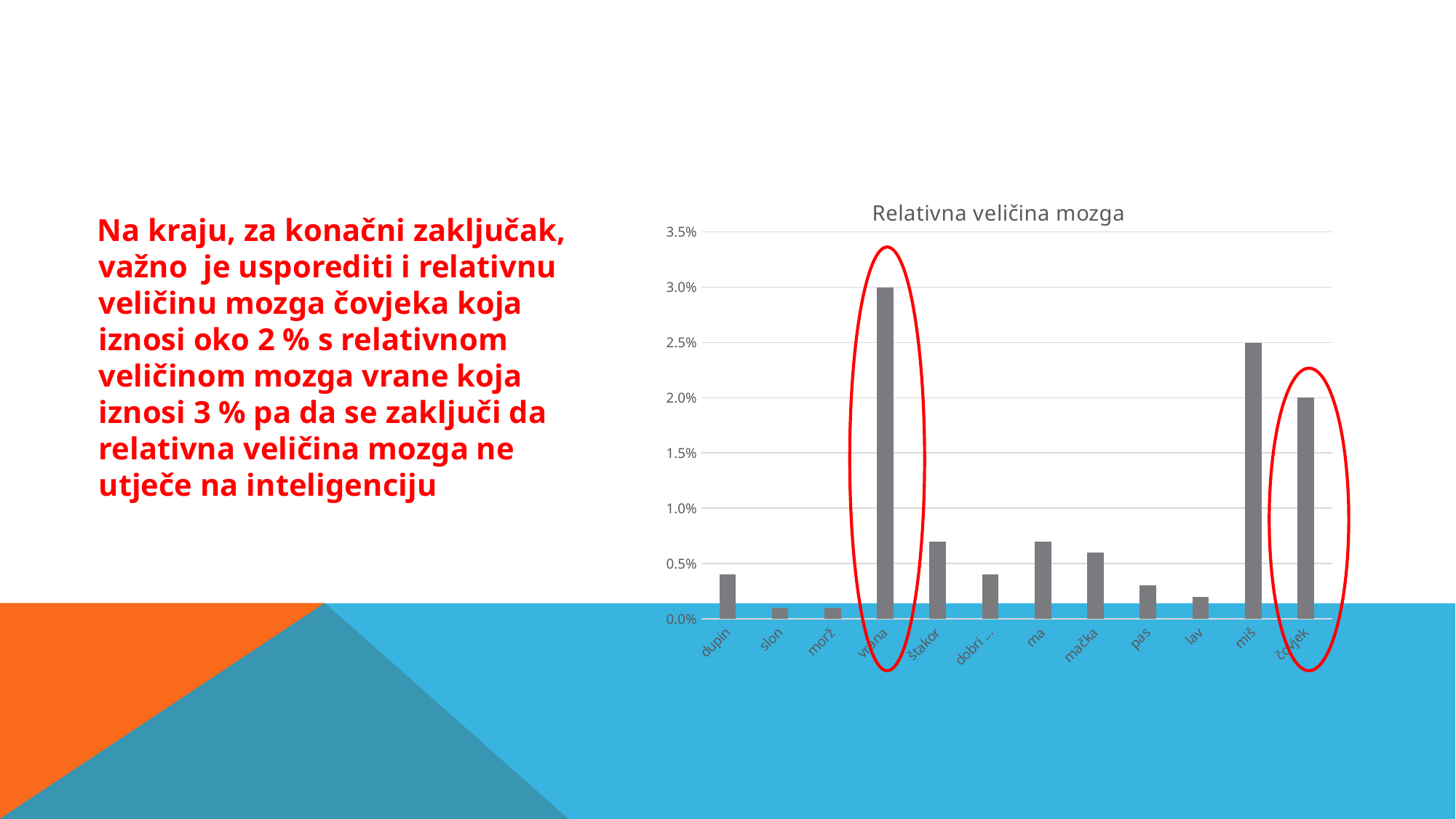
Is the value for mačka greater or less than 0.5%? greater What kind of chart is shown on the slide? bar chart What is the value for vrana in the chart? 3.0% What is the title of the chart? Relativna veličina mozga What is the value for čovjek in the chart? 2.0% Which has a larger value, miš or čovjek? miš What is the value for miš in the chart? 2.5% Is the value for štakor greater or less than 0.5%? greater How many categories are shown on the x axis of the chart? 12 Is the value for dupin greater or less than 0.5%? less What is the difference between the values for vrana and čovjek? 1.0% Which category has the highest value in the chart? vrana